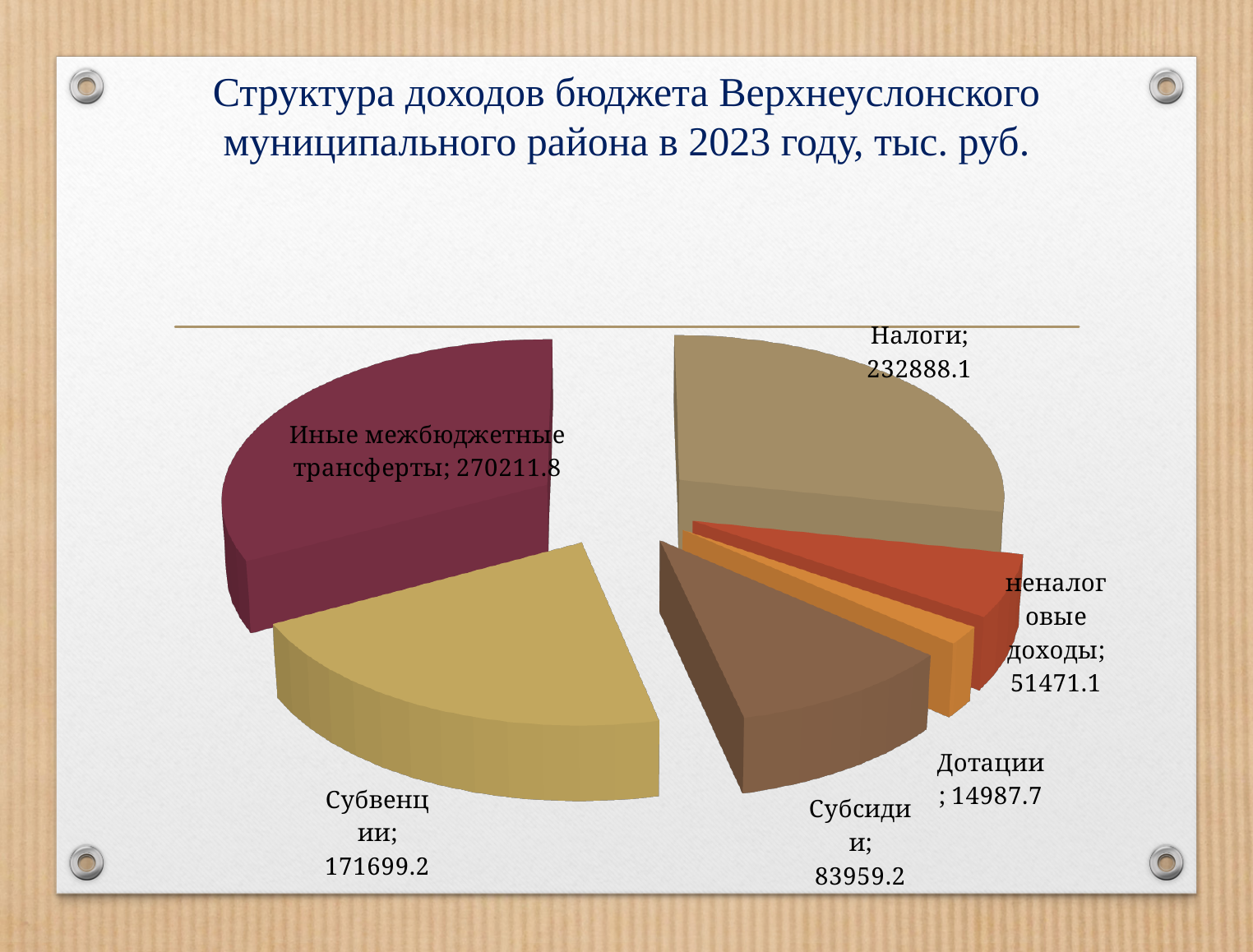
What is the value for Дотации? 14987.7 Which category has the smallest value? Дотации What is the value for неналоговые доходы? 51471.1 Which is larger, Субсидии or Субвенции? Субвенции What is the value for Иные межбюджетные трансферты? 270211.8 What is the difference between Иные межбюджетные трансферты and Налоги? 37323.7 Which category has the largest value? Иные межбюджетные трансферты What is the value for Налоги? 232888.1 What is the value for Субвенции? 171699.2 What year does the chart title say the budget income structure refers to? 2023 How many slices does the pie chart have? 6 What kind of chart is shown on the slide? pie chart